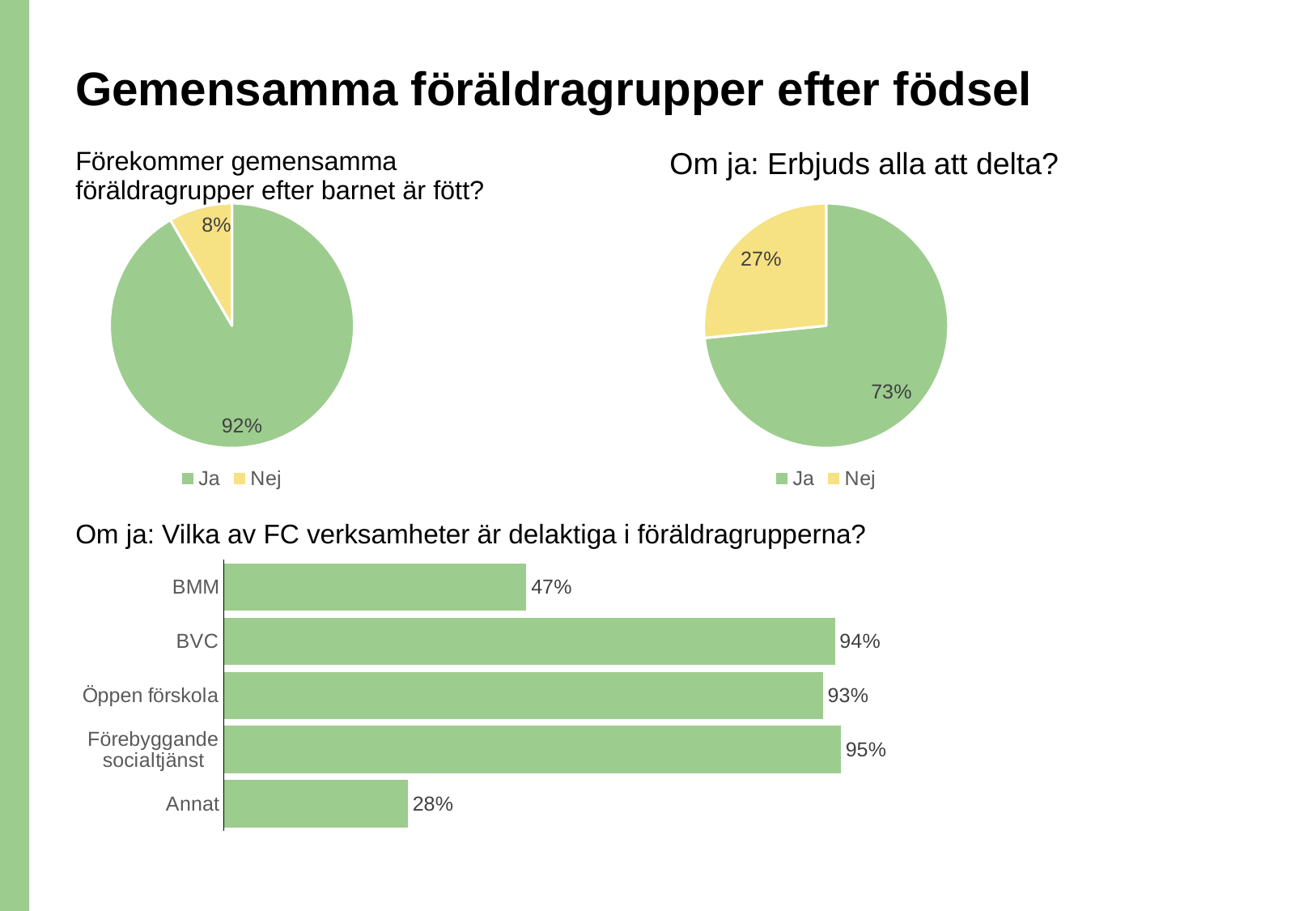
In the pie chart titled 'Förekommer gemensamma föräldragrupper efter barnet är fött?', what share is 'Ja'? 92% In the bar chart 'Om ja: Vilka av FC verksamheter är delaktiga i föräldragrupperna?', what is the value for BMM? 47% In the bar chart 'Om ja: Vilka av FC verksamheter är delaktiga i föräldragrupperna?', what is the difference between BVC and BMM? 47% In the pie chart titled 'Förekommer gemensamma föräldragrupper efter barnet är fött?', what share is 'Nej'? 8% In the pie chart titled 'Om ja: Erbjuds alla att delta?', what share is 'Ja'? 73% What kind of chart is used for 'Om ja: Vilka av FC verksamheter är delaktiga i föräldragrupperna?'? bar chart In the bar chart 'Om ja: Vilka av FC verksamheter är delaktiga i föräldragrupperna?', which category has the lowest value? Annat In the bar chart 'Om ja: Vilka av FC verksamheter är delaktiga i föräldragrupperna?', what is the value for Öppen förskola? 93% In the pie chart titled 'Om ja: Erbjuds alla att delta?', what is the difference between the 'Ja' and 'Nej' shares? 46% In the bar chart 'Om ja: Vilka av FC verksamheter är delaktiga i föräldragrupperna?', how many categories are shown? 5 In the bar chart 'Om ja: Vilka av FC verksamheter är delaktiga i föräldragrupperna?', which category has the highest value? Förebyggande socialtjänst